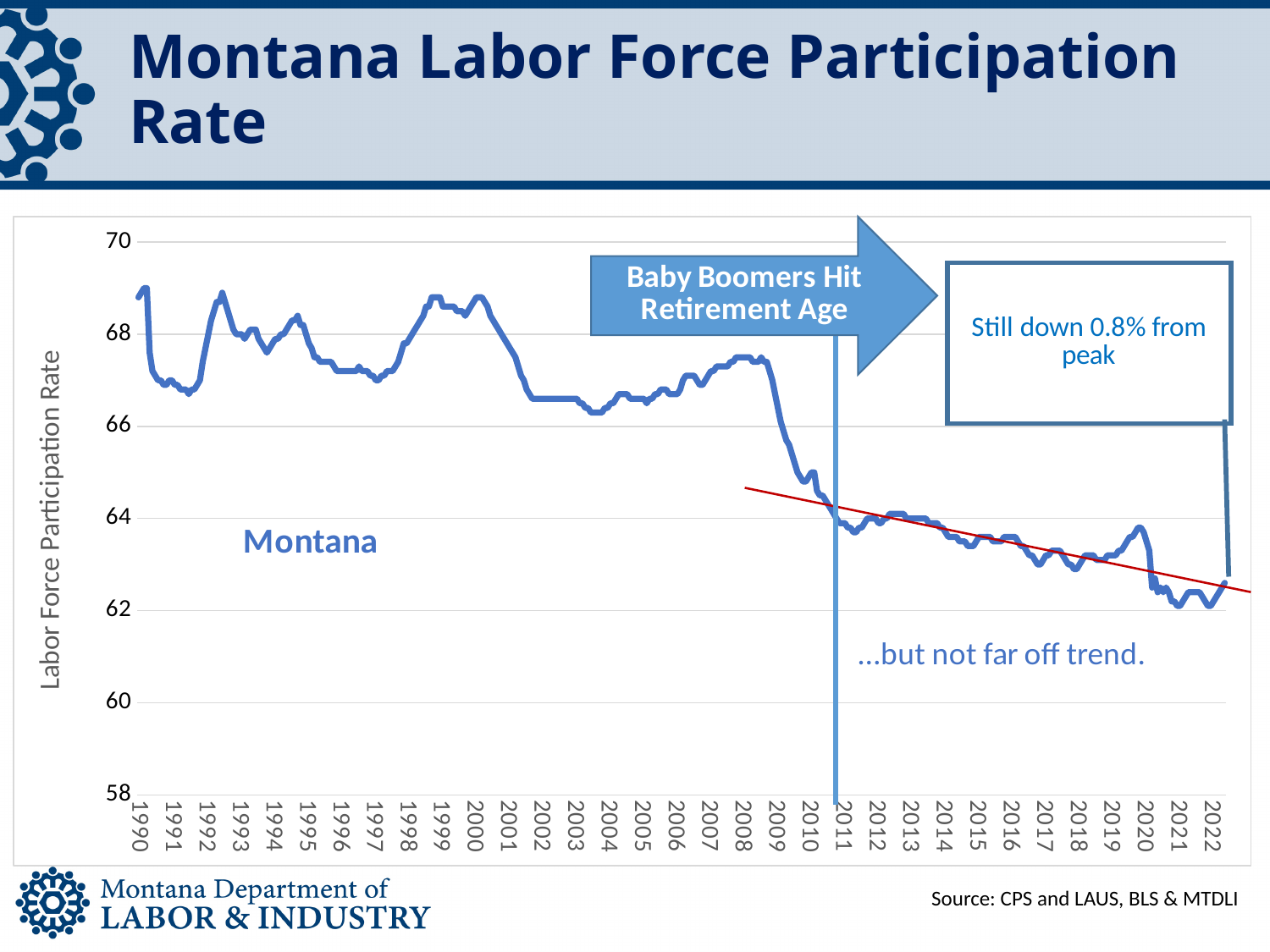
Is the value for 2021 greater or less than 64? less How many years are labeled on the x axis? 33 What event does the arrow annotation on the chart say happened around 2011? Baby Boomers Hit Retirement Age Is the value for 1990 greater or less than 68? greater Does the labor force participation rate rise or fall between 2011 and 2022? fall Overall, does the Montana labor force participation rate rise or fall between 1990 and 2022? fall Is the value for 1999 greater or less than 68? greater What kind of chart is shown on the slide? line chart What is the label on the y axis? Labor Force Participation Rate What is the first year shown on the x axis? 1990